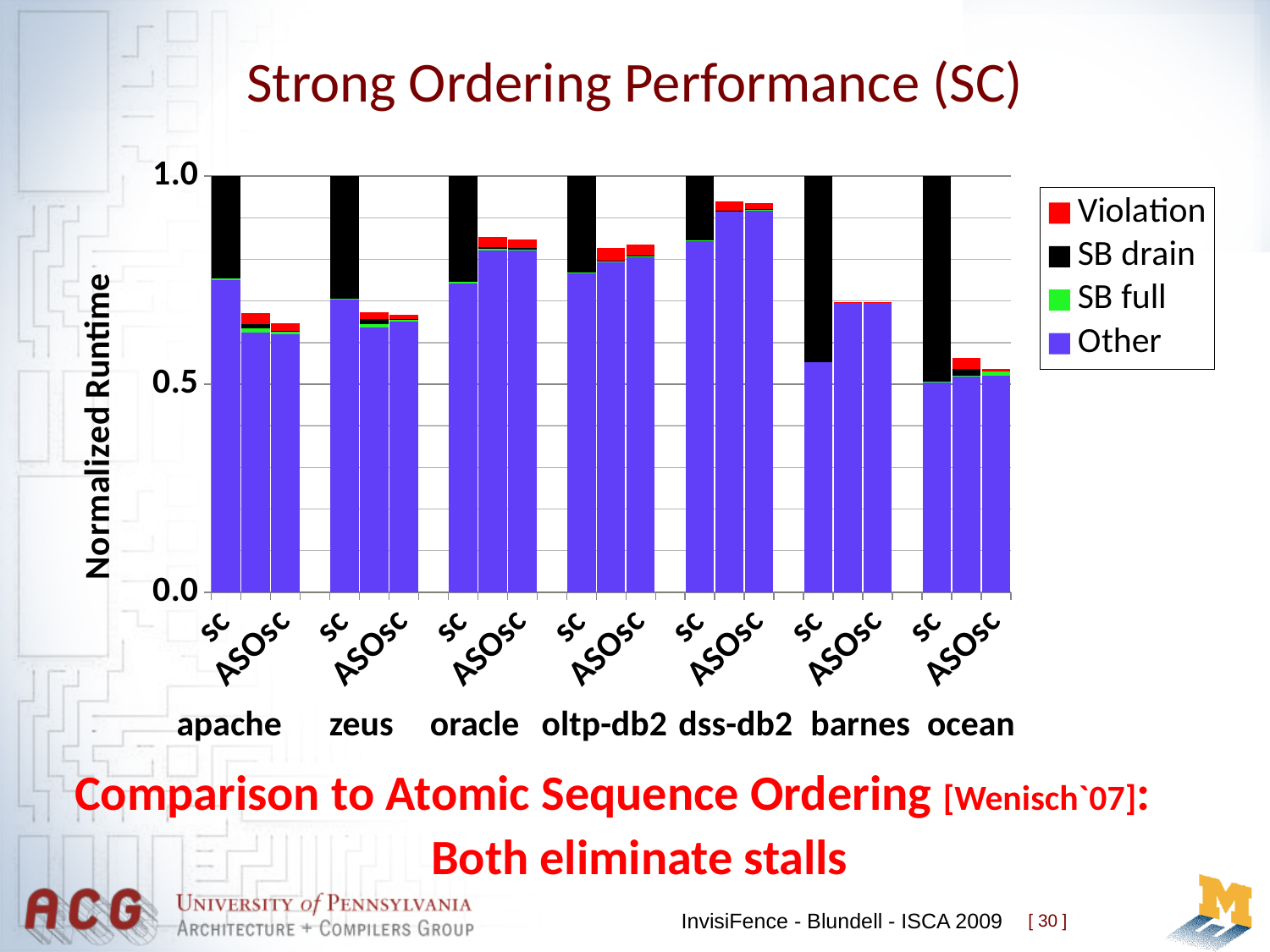
Is the total height of the ASO bar for barnes greater or less than 0.5? greater What kind of chart is shown on the slide? bar chart Which is larger, the Other segment of the sc bar for dss-db2 or the Other segment of the sc bar for barnes? dss-db2 How many benchmark groups are shown along the x axis? 7 What are the four legend entries? Violation, SB drain, SB full, Other Is the total height of the ASO bar for apache greater or less than 0.5? greater How many series does the legend list? 4 Which benchmark has the tallest ASO bar? dss-db2 Is the total height of the ASO bar for dss-db2 greater or less than 1.0? less What is the total height of the sc bar for apache? 1.0 What is the y-axis title of the chart? Normalized Runtime Which benchmark has the shortest ASO bar? ocean